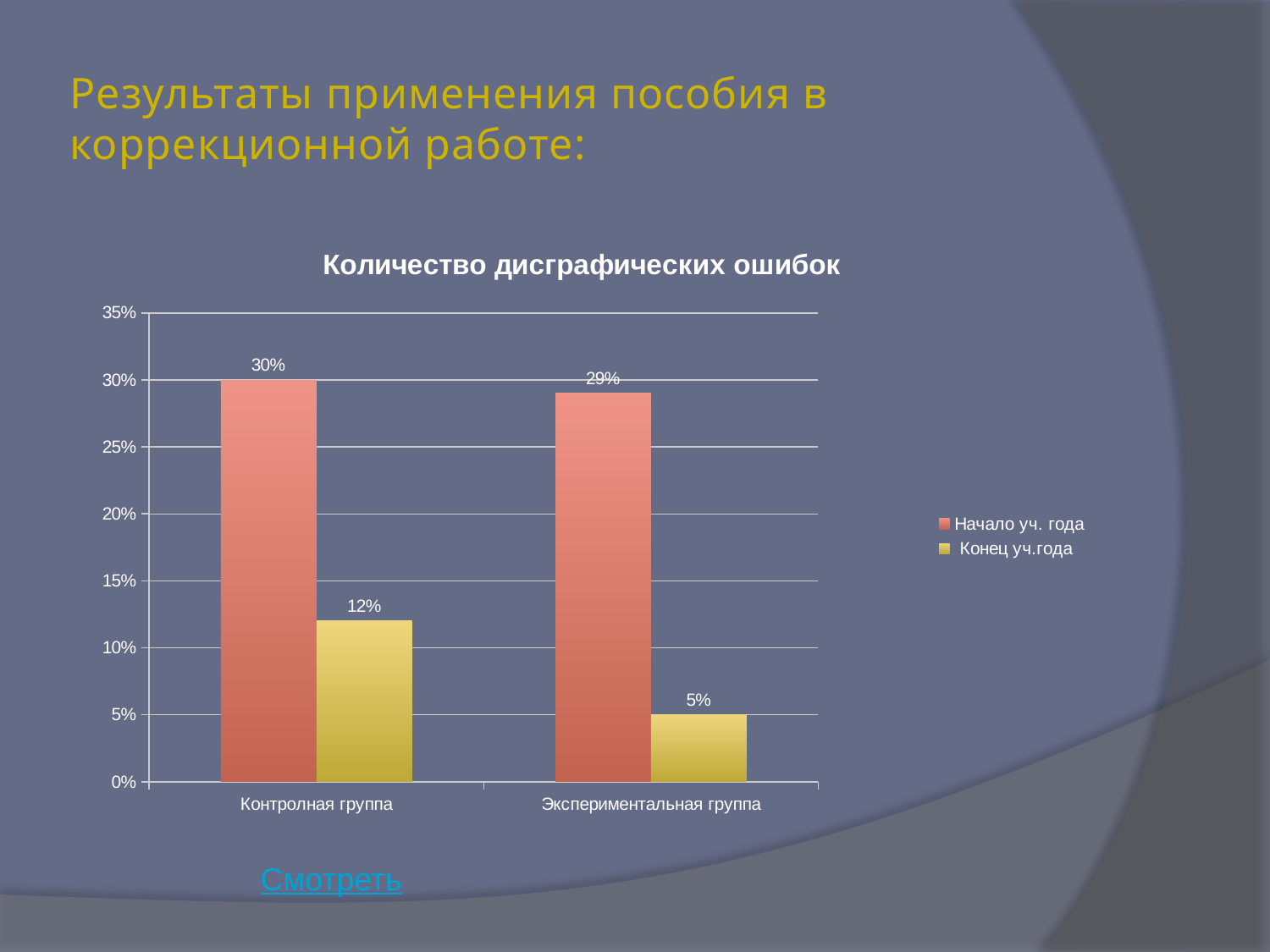
What kind of chart is shown on the slide? Bar chart What is the difference between the Начало уч. года and Конец уч.года values for Экспериментальная группа? 24% How many series does the legend list? 2 What is the value for Контролная группа in the Начало уч. года series? 30% How many categories are shown on the x axis? 2 What is the difference between the Начало уч. года and Конец уч.года values for Контролная группа? 18% What is the value for Экспериментальная группа in the Начало уч. года series? 29% What is the value for Экспериментальная группа in the Конец уч.года series? 5% What is the title of the chart? Количество дисграфических ошибок What is the value for Контролная группа in the Конец уч.года series? 12% Which is larger: the Конец уч.года value for Контролная группа or for Экспериментальная группа? Контролная группа Which category has the lowest value in the Конец уч.года series? Экспериментальная группа